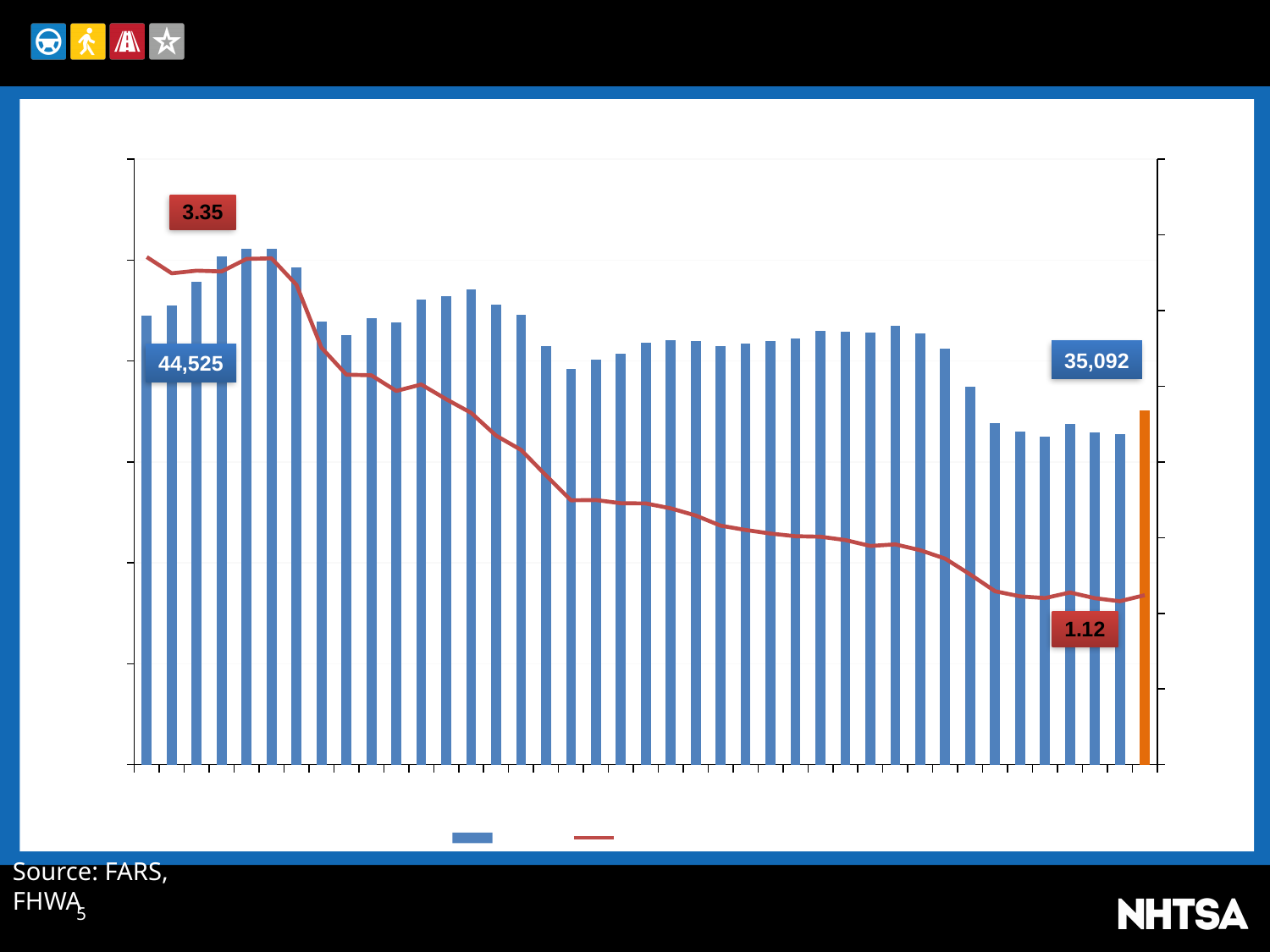
How many series does the legend below the chart show? 2 What colour is the last bar on the right of the chart? Orange By how much does the red line's labelled value fall from 3.35 at the start to 1.12 at the end? 2.23 Does the red line generally rise or fall from left to right across the chart? Fall What value is labelled on the first blue bar at the left of the chart? 44,525 Which is larger, the labelled value of the first bar or the labelled value of the last (orange) bar? The first bar (44,525) What value is labelled at the start of the red line on the left of the chart? 3.35 What kind of chart is shown on the slide? A bar chart combined with a line What value is labelled on the orange bar at the right end of the chart? 35,092 What value is labelled at the end of the red line on the right of the chart? 1.12 What is the difference between the first labelled bar value (44,525) and the last labelled bar value (35,092)? 9,433 What colour is the line plotted over the bars? Red